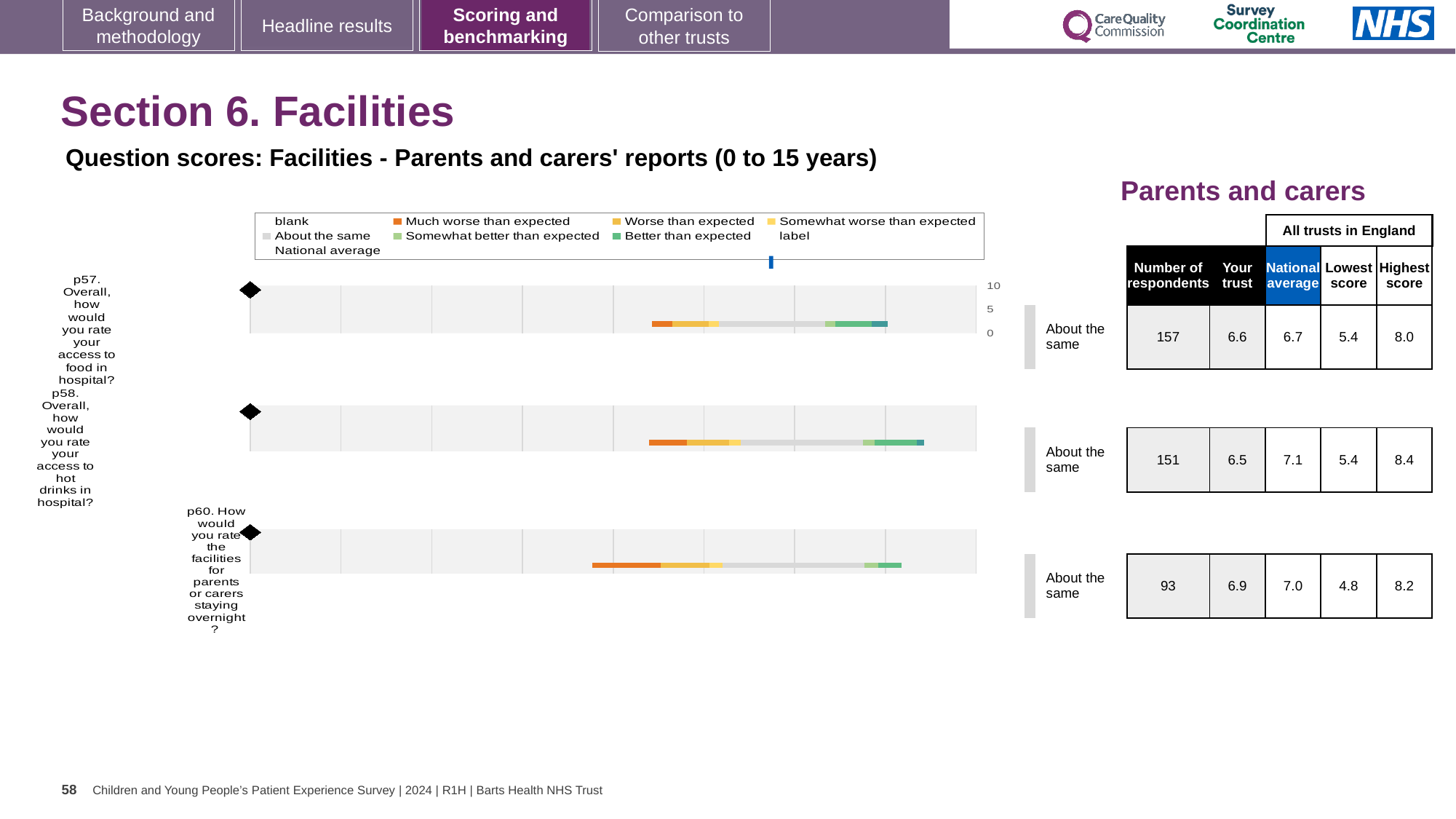
In the table beside the p58 chart, what is the highest score among all trusts in England? 8.4 For p58, which is larger: the 'Your trust' score or the national average? National average For p57, what is the difference between the highest score (8.0) and the lowest score (5.4) in the table? 2.6 What benchmark category label is shown next to each of the three question charts? About the same How many question charts (p57, p58, p60) are shown on the slide? 3 What kind of chart is used to show the p57 question score? bar chart In the table beside the p58 chart, what is the national average score? 7.1 What is the highest value shown on the score axis of the p57 chart? 10 Which of the three questions (p57, p58, p60) has the lowest 'Lowest score' value in the table? p60 Which of the three questions (p57, p58, p60) has the highest 'Your trust' score in the table? p60 In the table beside the p60 chart, how many respondents are listed? 93 In the table beside the p57 chart, what is the 'Your trust' score? 6.6